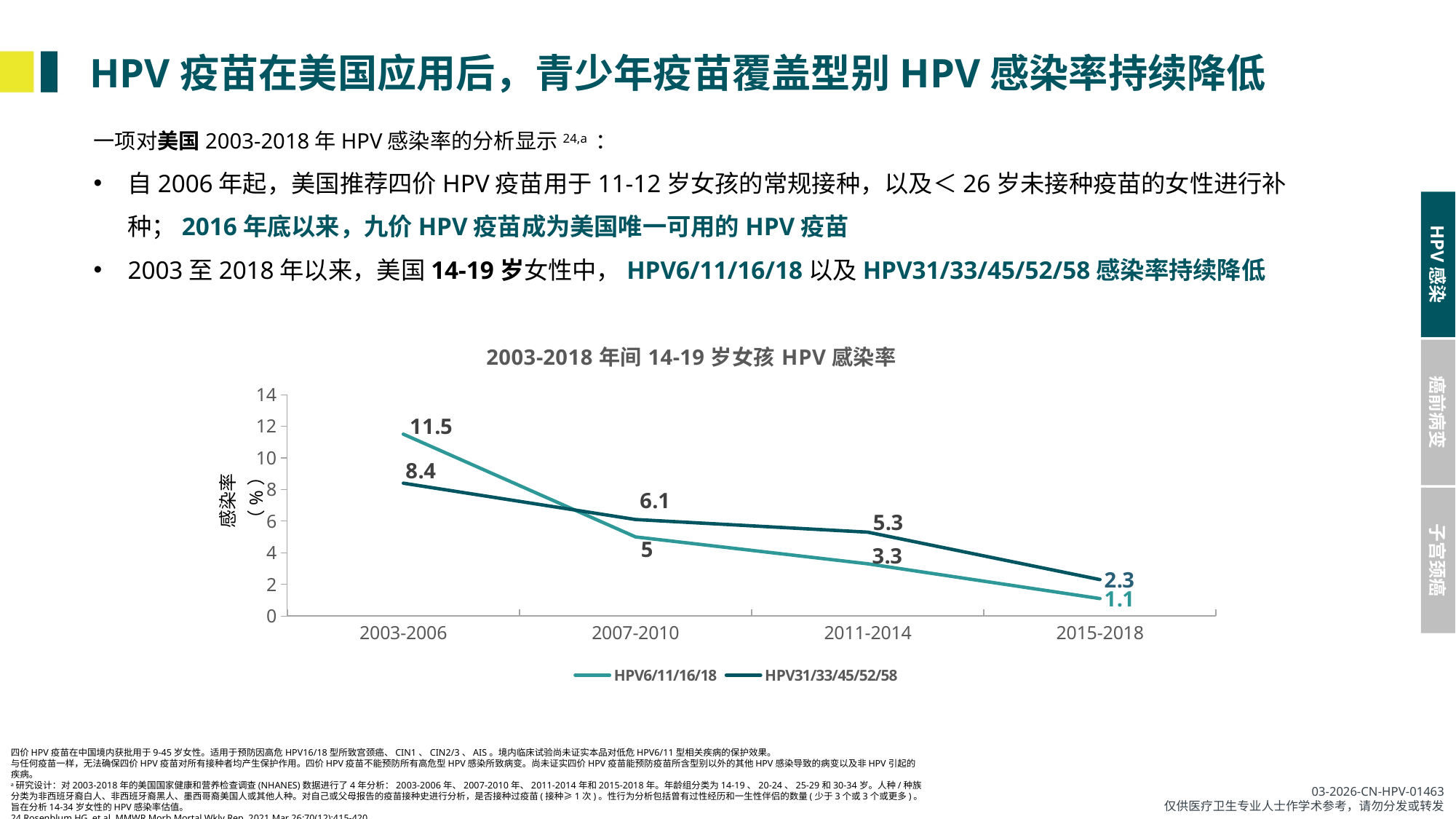
In which period is the HPV6/11/16/18 infection rate highest? 2003-2006 Which series has the higher infection rate in 2011-2014, HPV6/11/16/18 or HPV31/33/45/52/58? HPV31/33/45/52/58 What type of chart is shown on the slide? line chart How many time periods are shown on the x axis? 4 How many series does the legend list? 2 What is the HPV6/11/16/18 infection rate for 2015-2018? 1.1 What is the HPV31/33/45/52/58 infection rate for 2007-2010? 6.1 What is the difference between the HPV6/11/16/18 and HPV31/33/45/52/58 infection rates in 2003-2006? 3.1 What is the HPV31/33/45/52/58 infection rate for 2011-2014? 5.3 In which period is the HPV31/33/45/52/58 infection rate lowest? 2015-2018 Do the HPV6/11/16/18 infection rates rise or fall from 2003-2006 to 2015-2018? fall What is the HPV6/11/16/18 infection rate for 2003-2006? 11.5